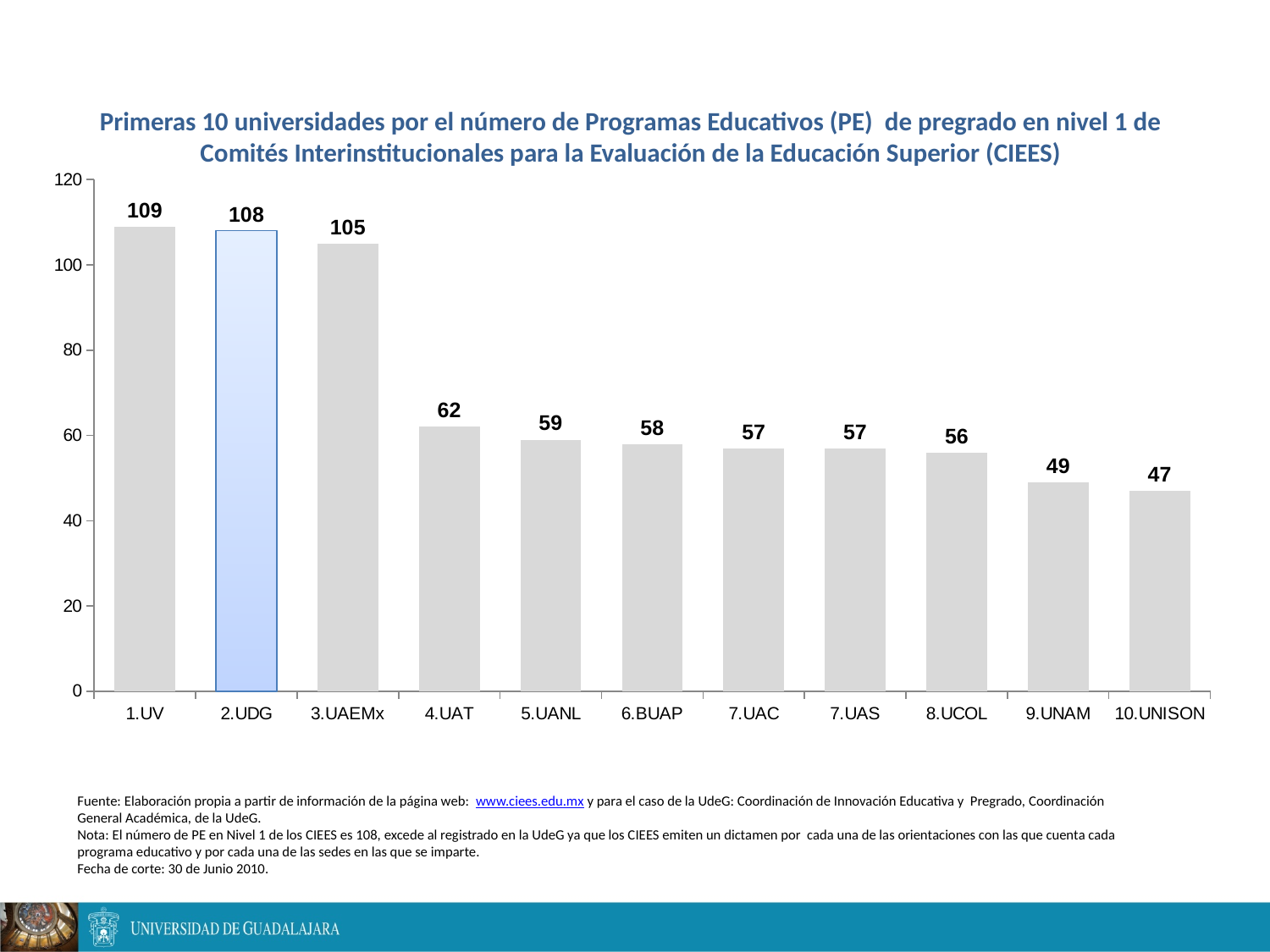
Which bar is highlighted in blue? 2.UDG Which university has the highest number of programs? 1.UV What is the difference between the values for 4.UAT and 9.UNAM? 13 Is the value for 8.UCOL greater or less than 60? less Which university has the lowest number of programs? 10.UNISON What is the value for 4.UAT? 62 What kind of chart is shown on the slide? bar chart How many universities are shown in the chart? 11 What is the value for 2.UDG? 108 What is the value for 10.UNISON? 47 Which is larger, the value for 3.UAEMx or the value for 5.UANL? 3.UAEMx What is the difference between the values for 1.UV and 3.UAEMx? 4